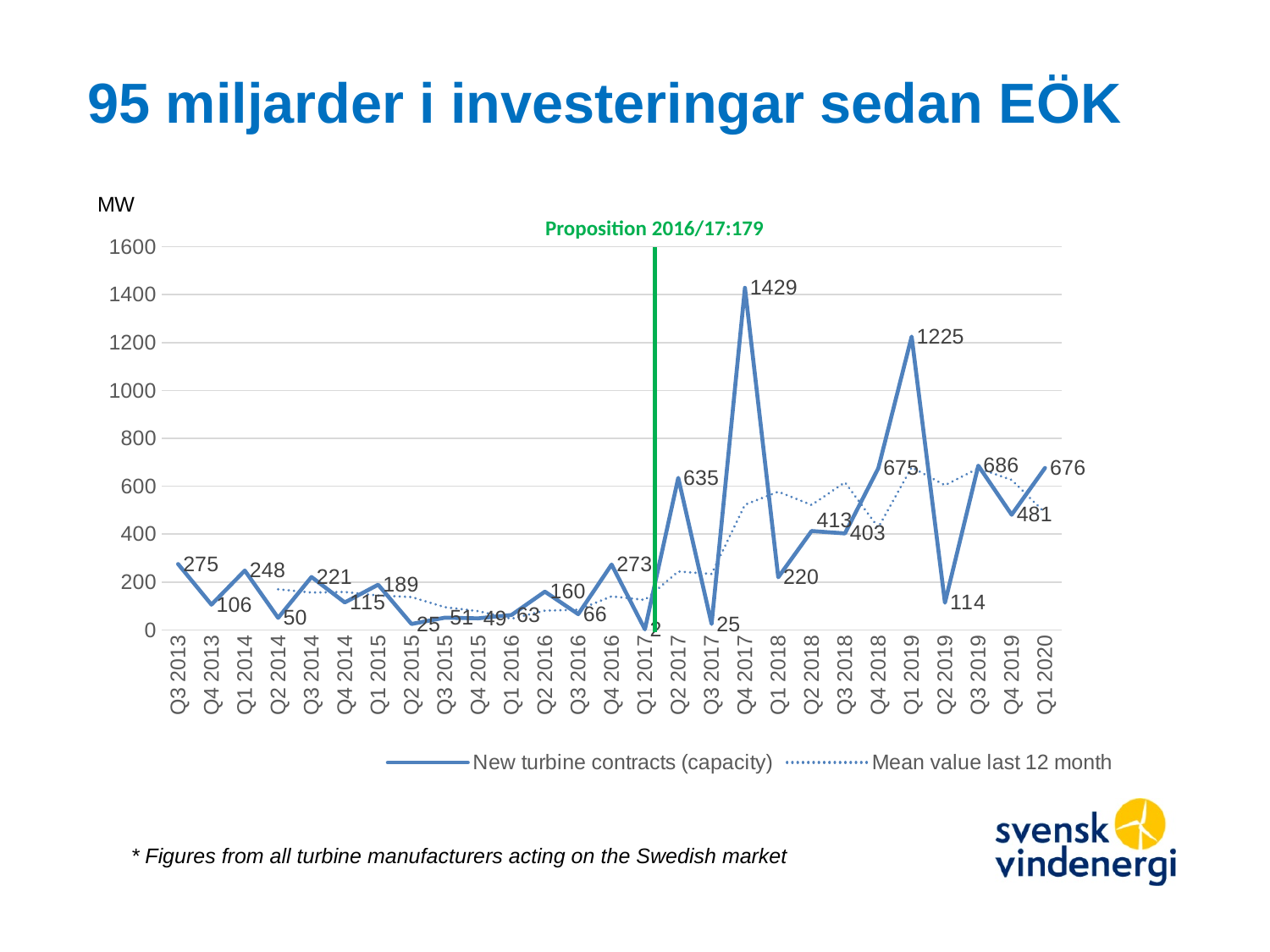
What is the difference between the New turbine contracts (capacity) values for Q4 2017 and Q1 2019? 204 Which is larger, the New turbine contracts (capacity) value for Q3 2019 or for Q4 2019? Q3 2019 What is the value of New turbine contracts (capacity) for Q1 2019? 1225 Which quarter has the lowest value for New turbine contracts (capacity)? Q1 2017 Which quarter has the highest value for New turbine contracts (capacity)? Q4 2017 What is the value of New turbine contracts (capacity) for Q4 2017? 1429 What is the value of New turbine contracts (capacity) for Q1 2020? 676 How many quarters are shown on the x axis? 27 How many series does the legend list? 2 What label is written on the green vertical line in the chart? Proposition 2016/17:179 What type of chart is shown on the slide? line chart Is the Mean value last 12 month for Q1 2020 greater or less than 400? greater